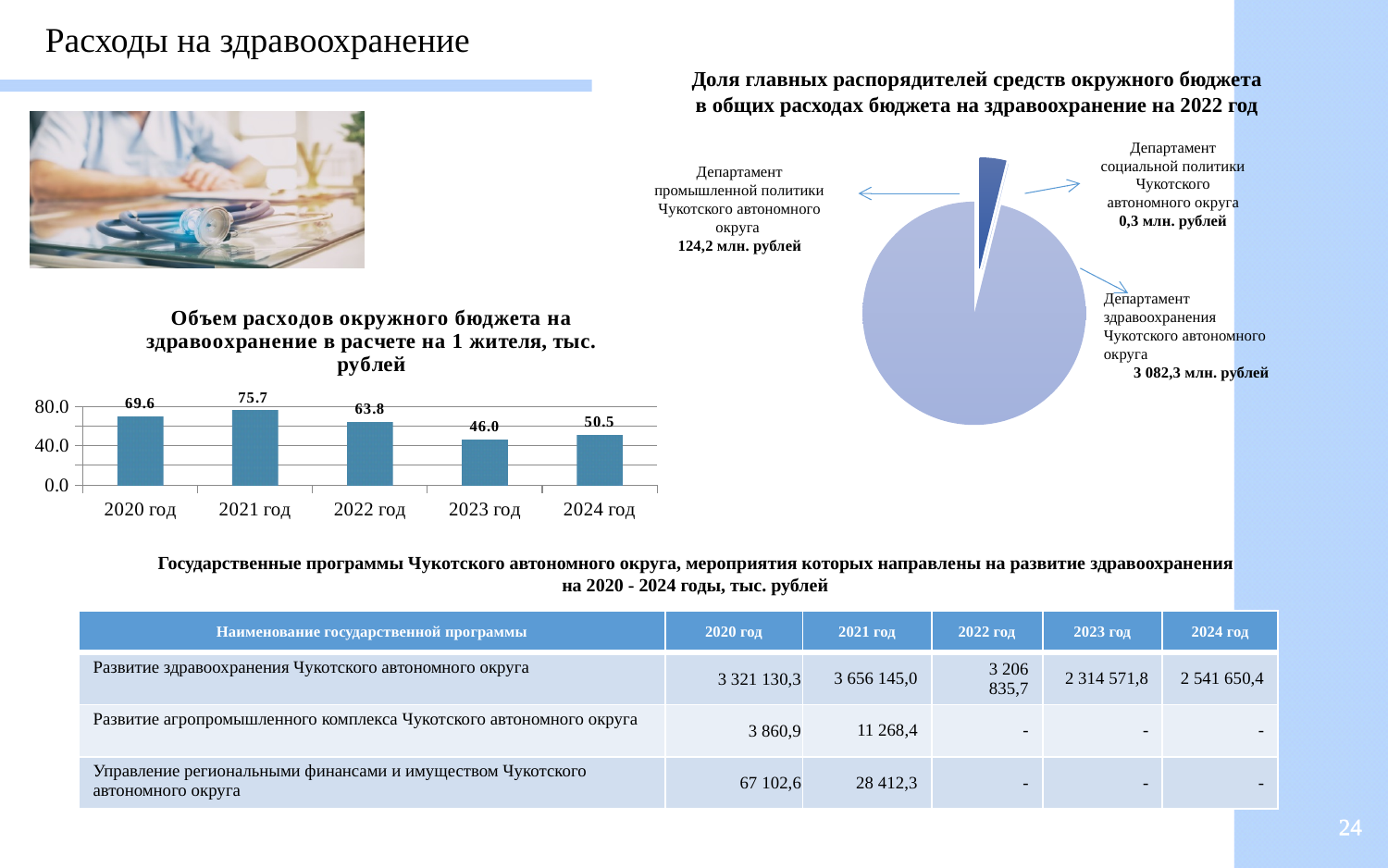
In the pie chart 'Доля главных распорядителей средств окружного бюджета в общих расходах бюджета на здравоохранение на 2022 год', what is the value for Департамент здравоохранения Чукотского автономного округа? 3 082,3 млн. рублей In the bar chart 'Объем расходов окружного бюджета на здравоохранение в расчете на 1 жителя', what is the difference between the values for 2021 год and 2020 год? 6.1 In the bar chart 'Объем расходов окружного бюджета на здравоохранение в расчете на 1 жителя', which year has the lowest value? 2023 год In the bar chart 'Объем расходов окружного бюджета на здравоохранение в расчете на 1 жителя', what is the value for 2021 год? 75.7 In the pie chart 'Доля главных распорядителей средств окружного бюджета в общих расходах бюджета на здравоохранение на 2022 год', which department has the smallest slice? Департамент социальной политики Чукотского автономного округа In the bar chart 'Объем расходов окружного бюджета на здравоохранение в расчете на 1 жителя', what is the value for 2023 год? 46.0 In the bar chart 'Объем расходов окружного бюджета на здравоохранение в расчете на 1 жителя', how many years are shown? 5 In the bar chart 'Объем расходов окружного бюджета на здравоохранение в расчете на 1 жителя', which year has the highest value? 2021 год In the bar chart 'Объем расходов окружного бюджета на здравоохранение в расчете на 1 жителя', which is larger, the value for 2022 год or 2024 год? 2022 год In the bar chart 'Объем расходов окружного бюджета на здравоохранение в расчете на 1 жителя', do the values rise or fall from 2021 год to 2023 год? Fall What kind of chart is 'Объем расходов окружного бюджета на здравоохранение в расчете на 1 жителя'? Bar chart In the pie chart 'Доля главных распорядителей средств окружного бюджета в общих расходах бюджета на здравоохранение на 2022 год', what is the value for Департамент промышленной политики Чукотского автономного округа? 124,2 млн. рублей